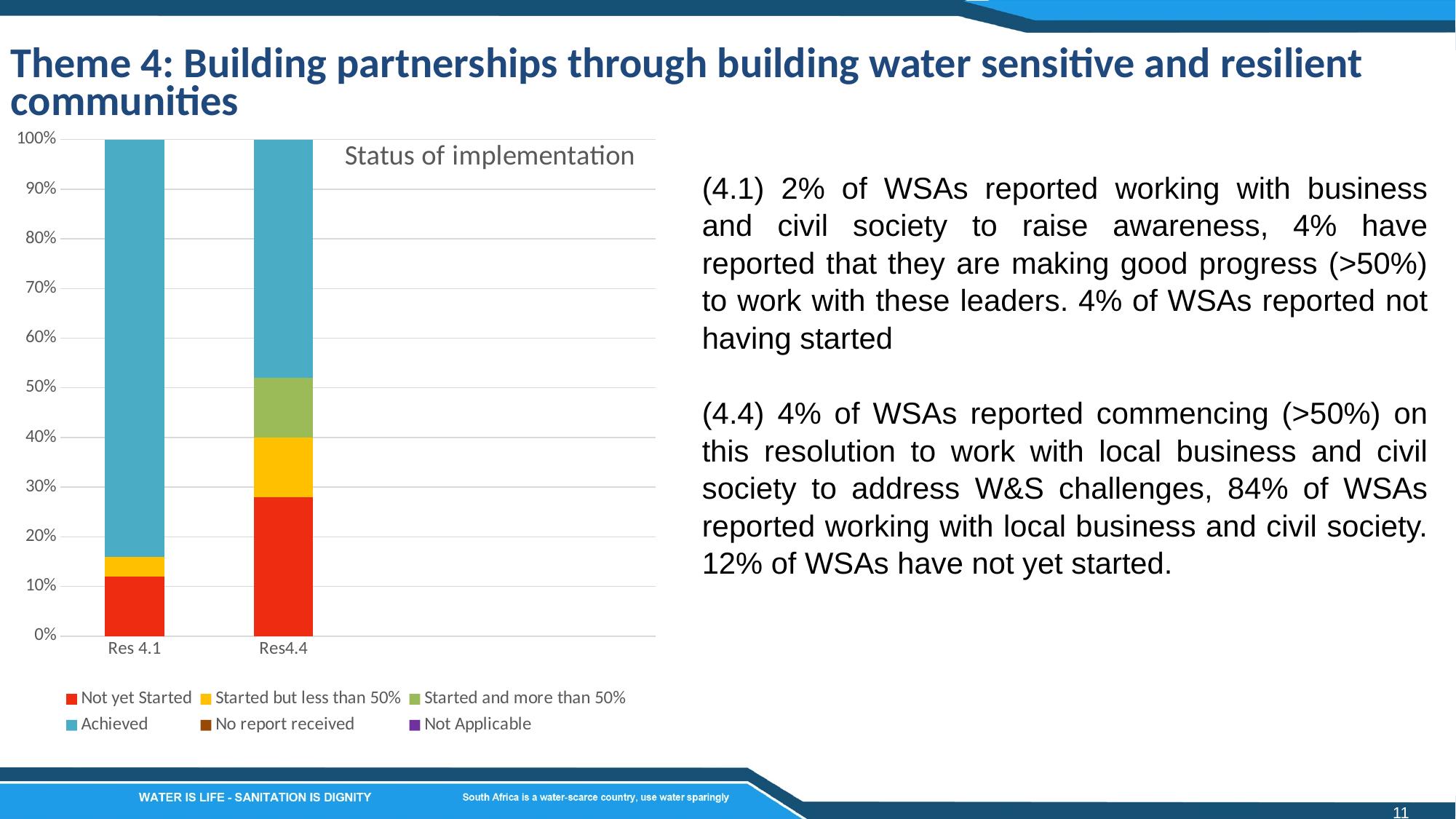
What type of chart is shown on the slide? Stacked bar chart Which series appears in the Res4.4 bar but not in the Res 4.1 bar? Started and more than 50% Is the 'Not yet Started' segment for Res 4.1 greater or less than 20%? less Is the 'Achieved' segment for Res 4.1 greater or less than 70%? greater Which category has the larger 'Started but less than 50%' segment, Res 4.1 or Res4.4? Res4.4 Is the 'Not yet Started' segment for Res4.4 greater or less than 20%? greater Which category has the larger 'Achieved' segment, Res 4.1 or Res4.4? Res 4.1 What is the title of the chart? Status of implementation What is the total height of the Res 4.1 stacked bar? 100% Which category has the larger 'Not yet Started' segment, Res 4.1 or Res4.4? Res4.4 How many series does the chart legend list? 6 How many categories are shown on the x axis of the chart? 2